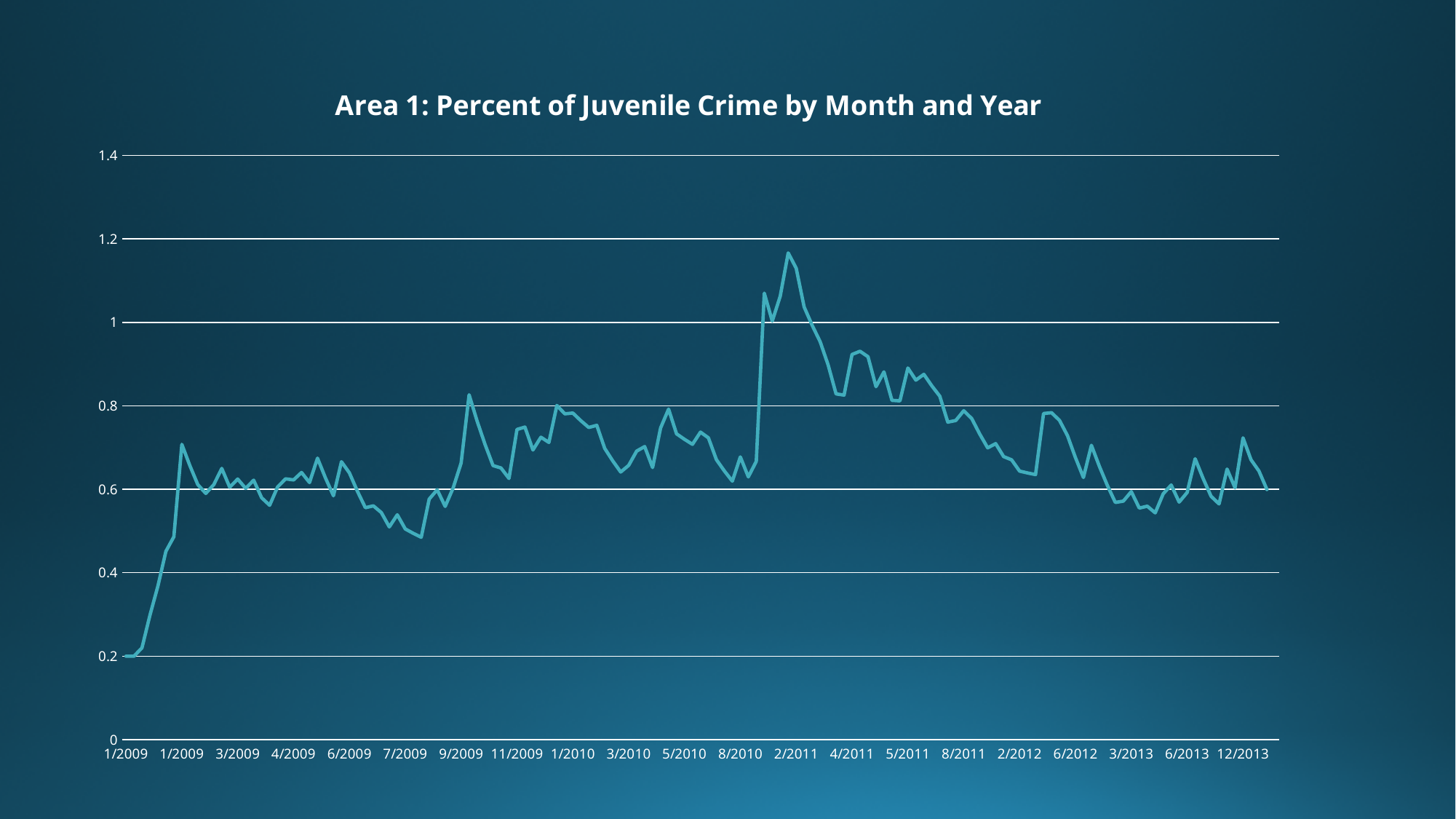
At which labelled month is the line at its lowest value? 1/2009 Is the value at 7/2009 greater or less than 0.6? less What is the value at the first point, 1/2009? 0.2 What kind of chart is shown on the slide? line chart What is the highest value shown on the y axis? 1.4 What is the title of the chart? Area 1: Percent of Juvenile Crime by Month and Year Is the peak value of the line near 2/2011 greater or less than 1? greater Does the line generally rise or fall between 2/2011 and 2/2012? fall Is the value at 2/2012 greater or less than 0.6? greater How many labels are shown along the x axis? 21 Near which labelled month does the line reach its highest value? 2/2011